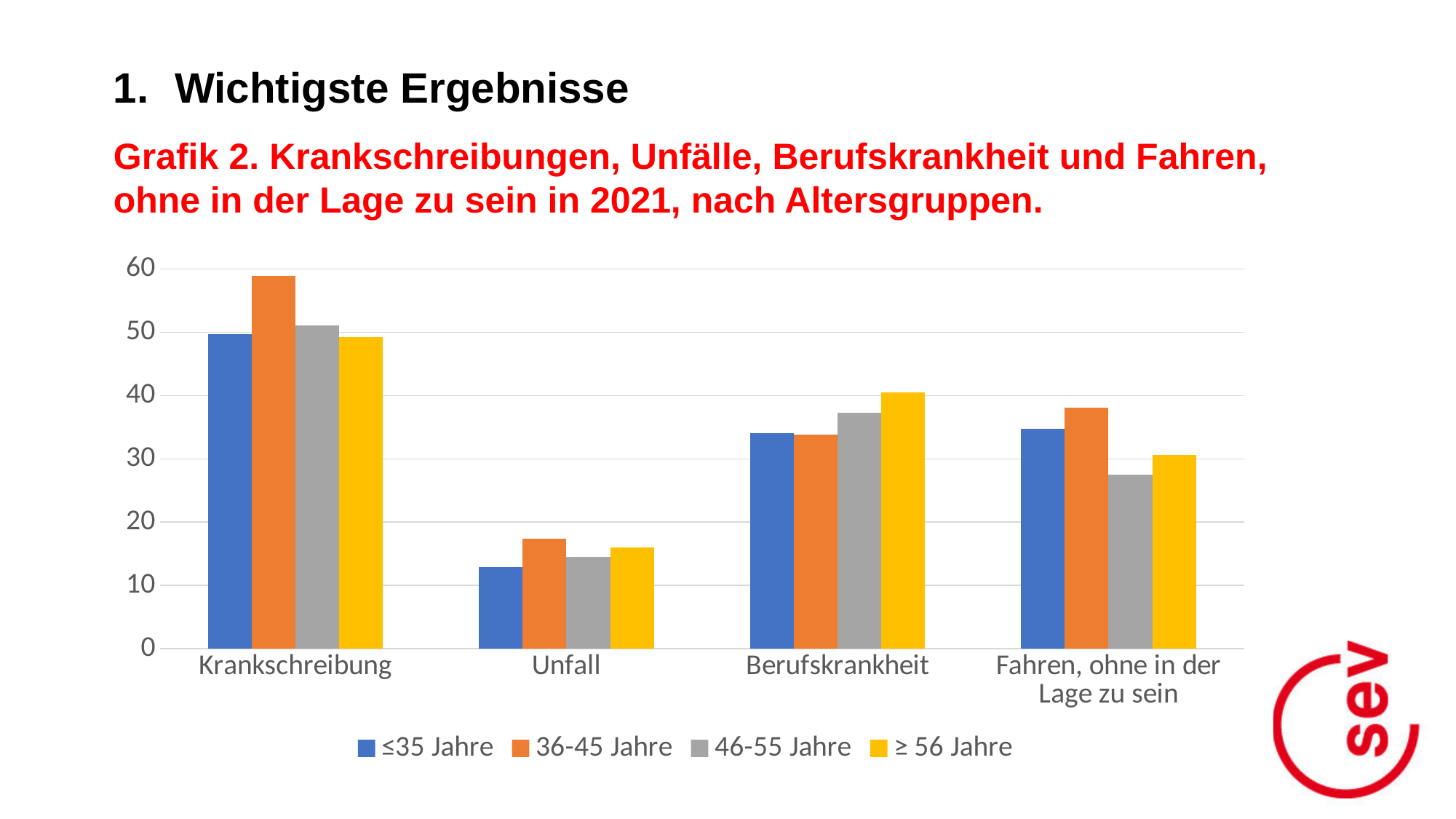
How many categories are shown on the x axis of the chart? 4 For Fahren, ohne in der Lage zu sein, which is larger: 36-45 Jahre or 46-55 Jahre? 36-45 Jahre Is the value for 46-55 Jahre in Fahren, ohne in der Lage zu sein greater or less than 30? less Which age group has the highest value for Berufskrankheit? ≥ 56 Jahre Is the value for 36-45 Jahre in Krankschreibung greater or less than 50? greater Is the value for ≤35 Jahre in Unfall greater or less than 20? less How many series does the legend list? 4 What kind of chart is shown on the slide? bar chart What colour represents the ≥ 56 Jahre series in the chart? yellow Which category has the lowest value for the ≤35 Jahre series? Unfall Which age group has the lowest value for Fahren, ohne in der Lage zu sein? 46-55 Jahre Which age group has the highest value for Krankschreibung? 36-45 Jahre